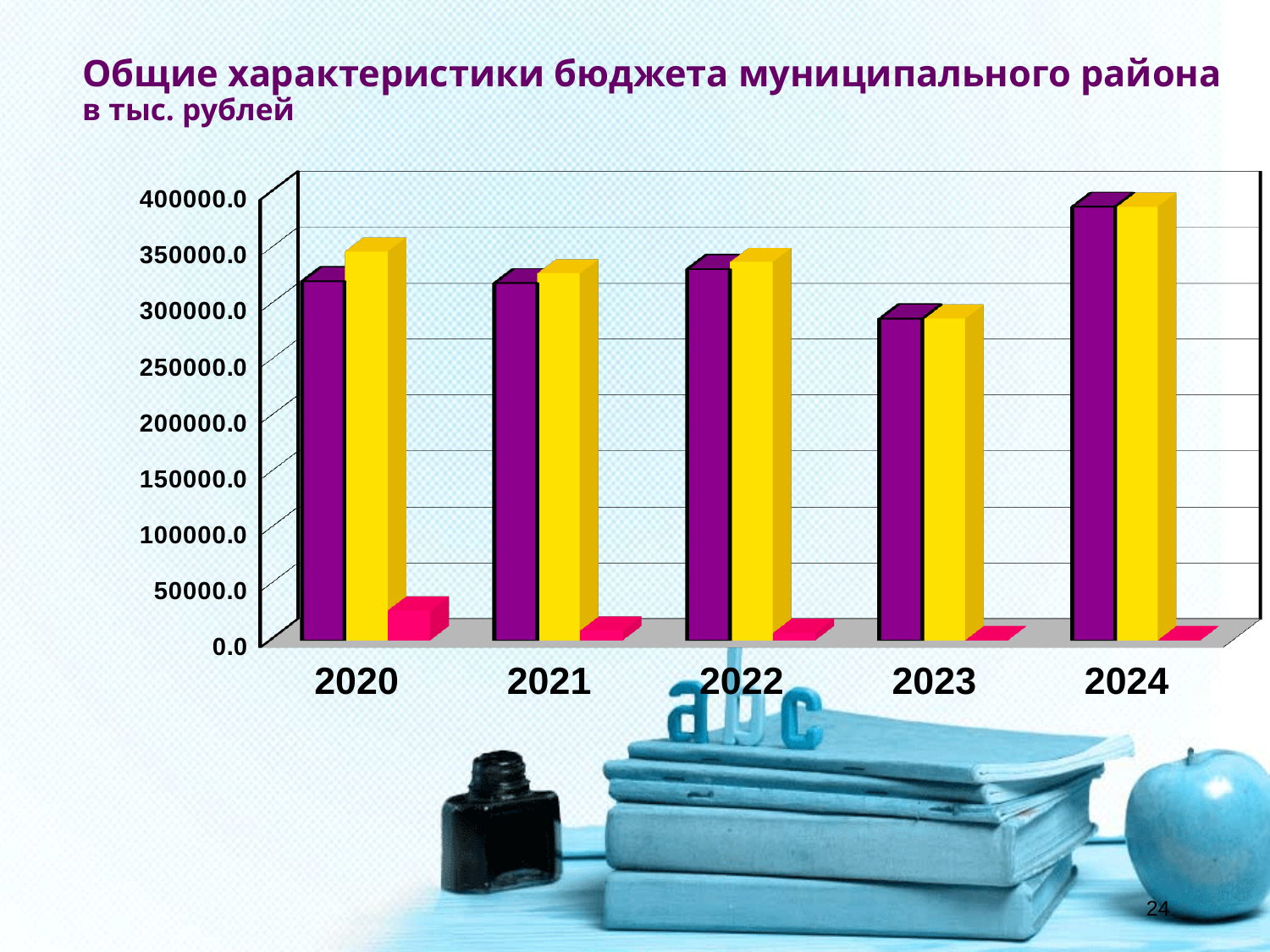
Is the value of the purple bar for 2023 greater or less than 300000.0? less Is the value of the pink bar for 2020 greater or less than 50000.0? less Do the pink bars generally rise or fall from 2020 to 2024? fall In which year is the purple bar the shortest? 2023 How many years are shown on the x axis of the chart? 5 Is the value of the purple bar for 2024 greater or less than 350000.0? greater In what units are the values on the chart given, according to the subtitle? в тыс. рублей What kind of chart is shown on the slide? bar chart In which year is the purple bar the tallest? 2024 For 2020, which is larger: the purple bar or the yellow bar? the yellow bar In which year is the pink bar the tallest? 2020 What is the title of the chart on the slide? Общие характеристики бюджета муниципального района